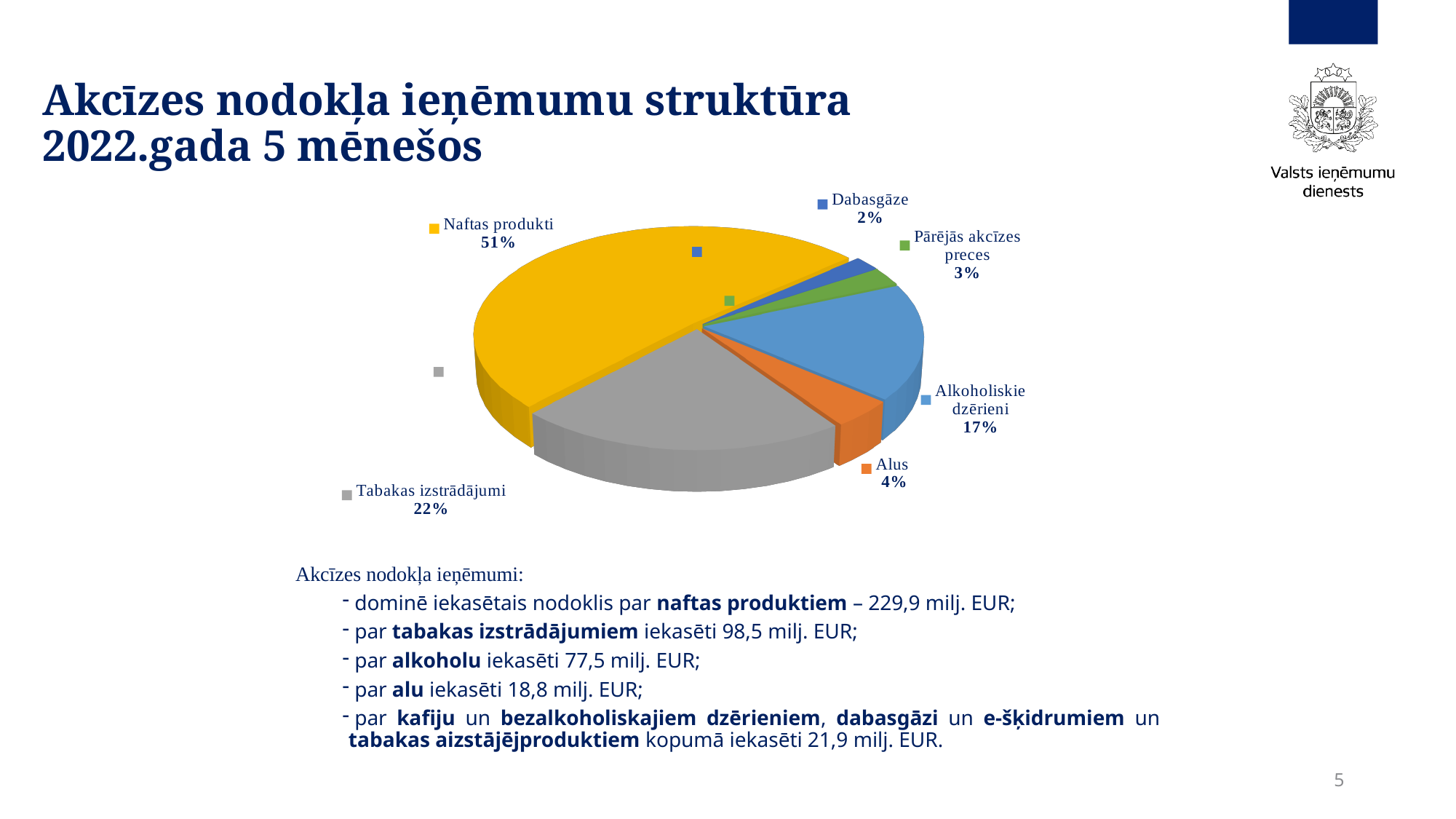
What kind of chart is shown on the slide? Pie chart Which category has the largest slice of the pie? Naftas produkti Which category has the smallest slice of the pie? Dabasgāze What is the difference in percentage points between Naftas produkti and Tabakas izstrādājumi? 29 What share of the pie does Dabasgāze hold? 2% How many categories are shown in the pie chart? 6 What colour is the Tabakas izstrādājumi slice? Grey What share of the pie does Tabakas izstrādājumi hold? 22% What share of the pie does Alkoholiskie dzērieni hold? 17% Which slice is larger, Alkoholiskie dzērieni or Alus? Alkoholiskie dzērieni